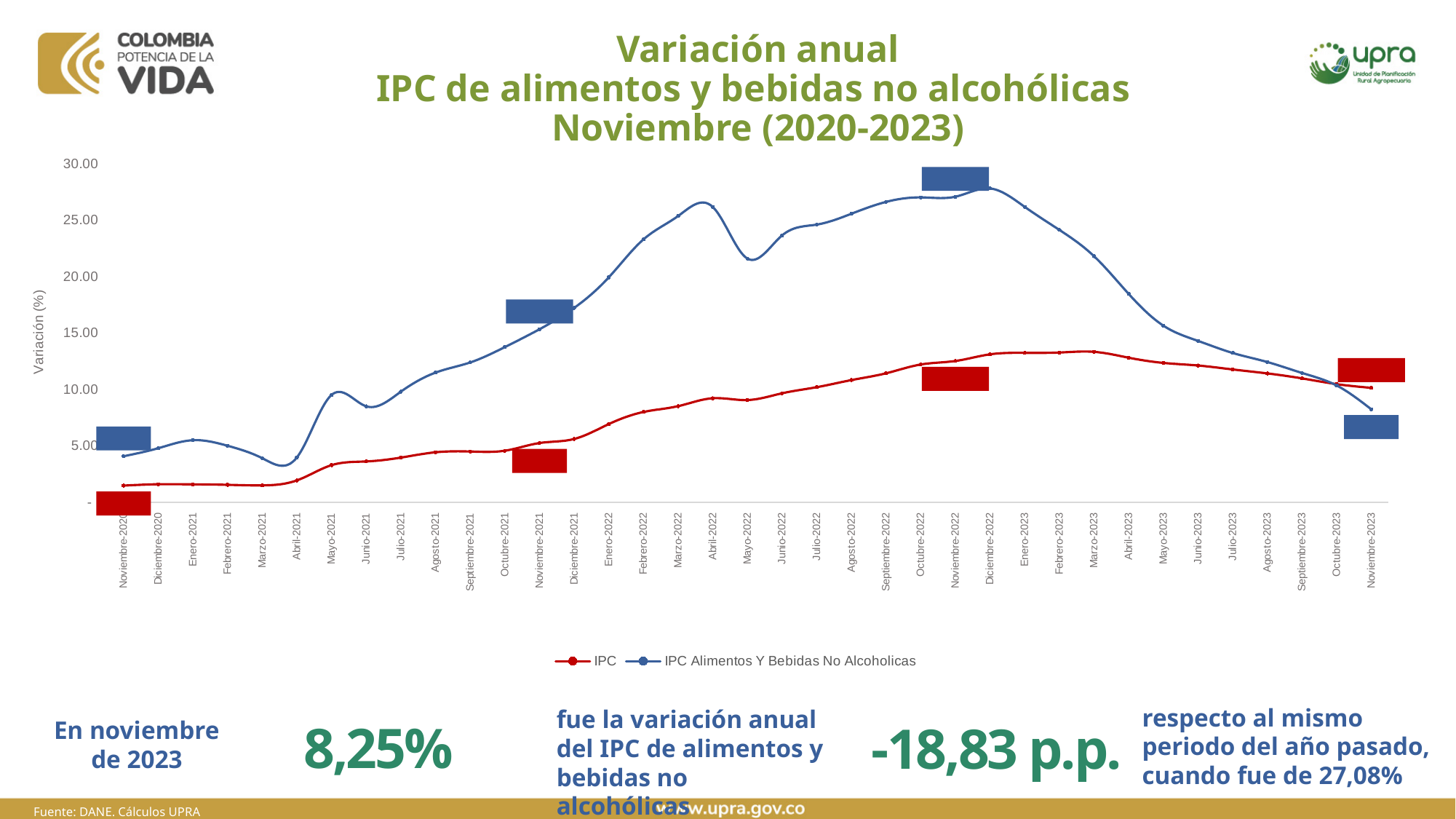
Is the value of IPC in Marzo-2023 greater or less than 10.00? greater In Noviembre-2023, which series has the higher value, IPC or IPC Alimentos Y Bebidas No Alcoholicas? IPC By how much did the annual variation of the IPC de alimentos y bebidas no alcohólicas change from November 2022 to November 2023? -18,83 p.p. Is the value of IPC Alimentos Y Bebidas No Alcoholicas in Abril-2022 greater or less than 25.00? greater What was the annual variation of the IPC de alimentos y bebidas no alcohólicas in November 2022? 27,08% How many series does the legend list? 2 How many months are plotted along the x axis? 37 Does the IPC Alimentos Y Bebidas No Alcoholicas series rise or fall from Diciembre-2022 to Noviembre-2023? fall What was the annual variation of the IPC de alimentos y bebidas no alcohólicas in November 2023? 8,25% What kind of chart is shown on the slide? line chart In which month does the IPC Alimentos Y Bebidas No Alcoholicas series reach its highest value? Diciembre-2022